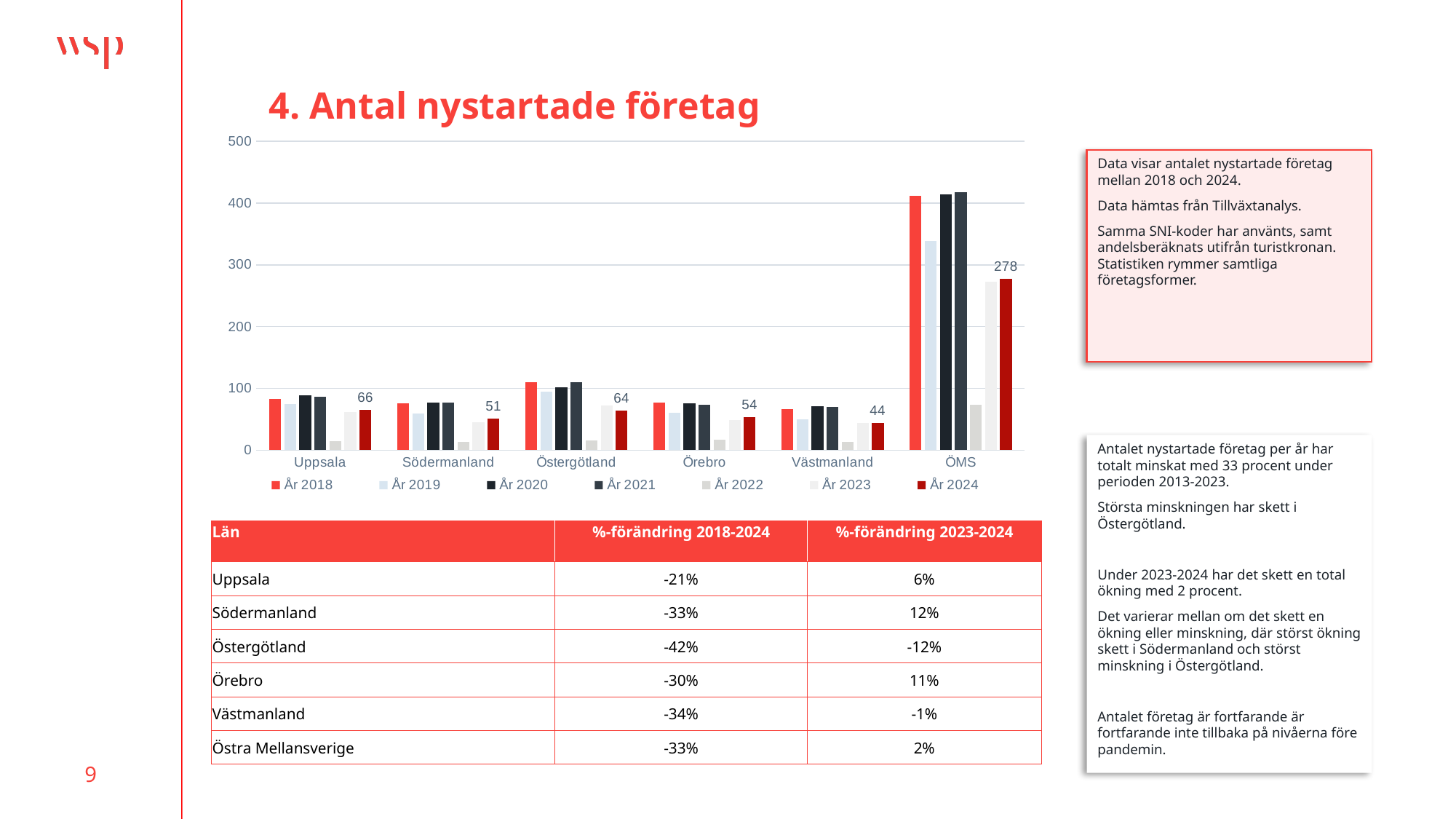
Is the value for År 2022 in ÖMS greater or less than 100? less Is the value for År 2019 in ÖMS greater or less than 400? less How many series does the chart legend list? 7 How many categories are shown on the x axis of the chart? 6 What is the value for År 2024 in Västmanland? 44 Which has the larger År 2024 value, Östergötland or Örebro? Östergötland What is the value for År 2024 in ÖMS? 278 What is the difference between the År 2024 values for ÖMS and Uppsala? 212 Which category has the highest value for År 2024? ÖMS What is the value for År 2024 in Uppsala? 66 What kind of chart is shown on the slide? bar chart Which category has the lowest value for År 2024? Västmanland